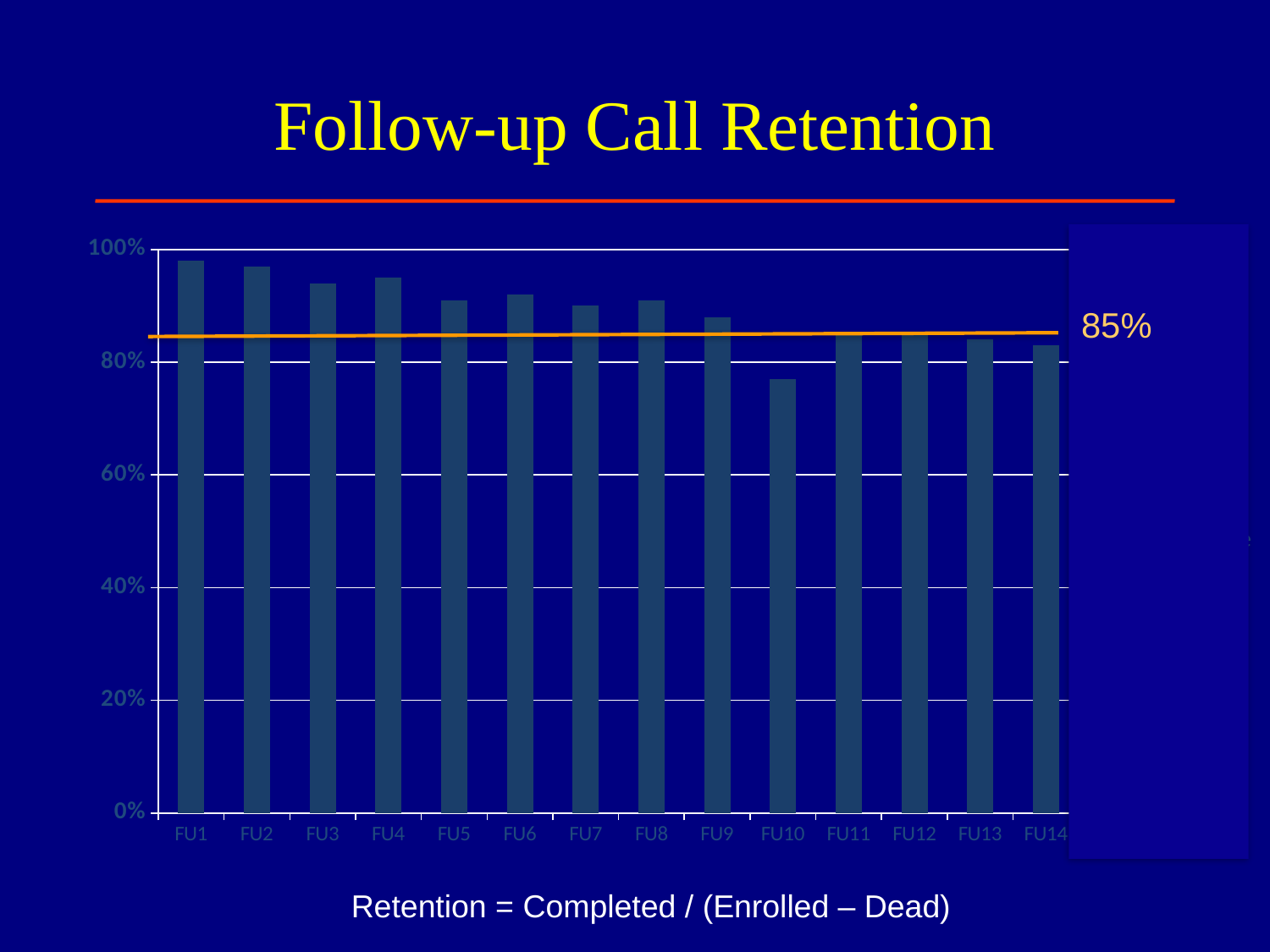
How many follow-up categories are plotted on the x axis? 14 Is the retention value for FU1 greater or less than 80%? greater Which has the higher retention, FU1 or FU10? FU1 Is the retention value for FU10 greater or less than 80%? less Do the retention values generally rise or fall from FU1 to FU14? fall Is the retention value for FU14 greater or less than 60%? greater What value is marked by the horizontal reference line across the chart? 85% What is the title of the chart? Follow-up Call Retention What kind of chart is shown on the slide? bar chart Which follow-up call has the highest retention? FU1 Which follow-up call has the lowest retention? FU10 Which has the higher retention, FU9 or FU10? FU9